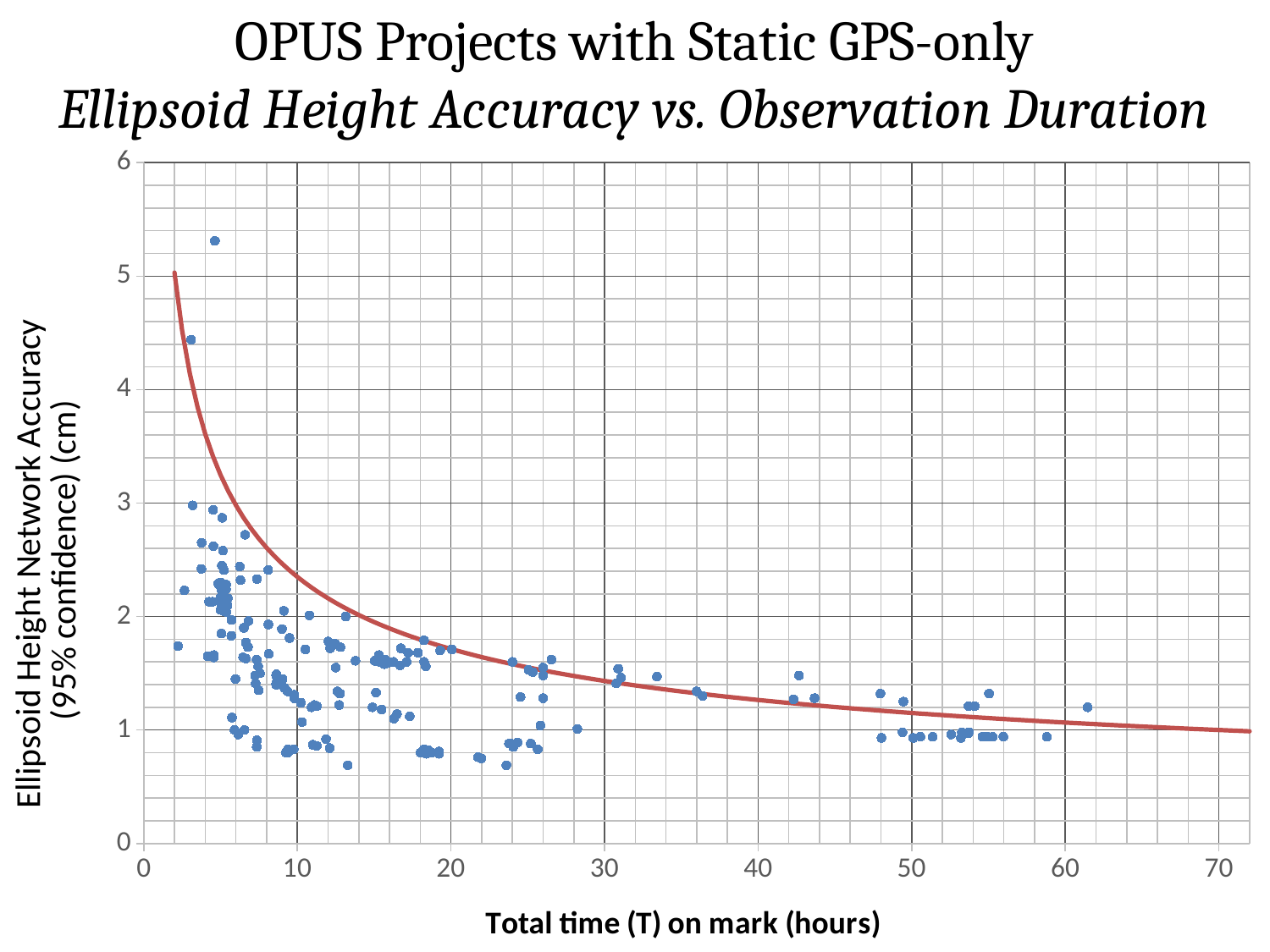
Is the plotted point at about 61 hours greater or less than 2? less Does the fitted trend line rise or fall as total time on mark increases? fall Is the highest plotted ellipsoid height accuracy value greater or less than 5? greater Is the value of the fitted trend line at its left end (around 2 hours) greater or less than 4? greater What kind of chart is shown on the slide? scatter chart What is the label of the x axis? Total time (T) on mark (hours) What is the main title of the chart? OPUS Projects with Static GPS-only